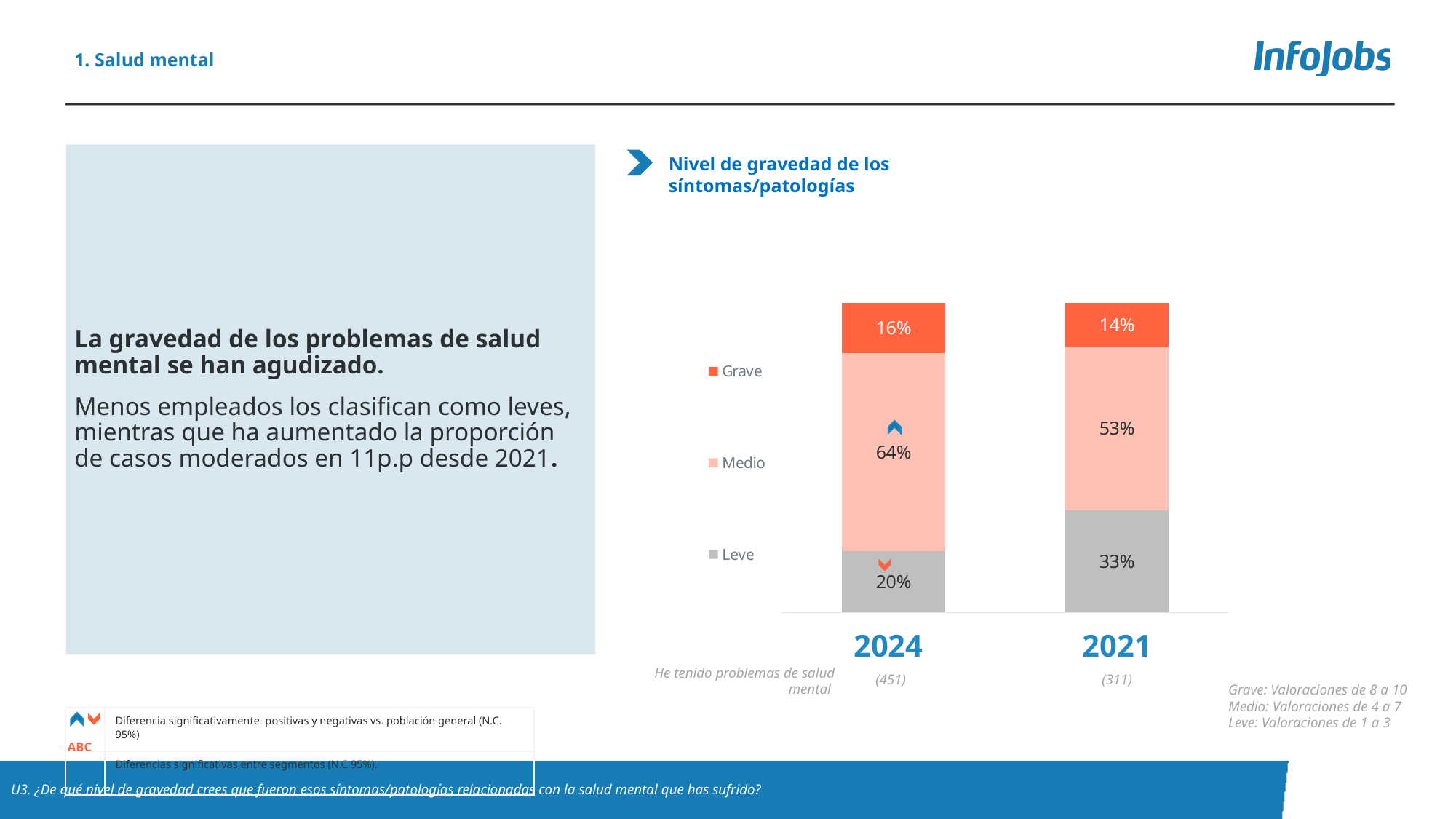
How many series does the legend list? 3 What is the total of the stacked bar for 2024? 100% What type of chart is shown on the slide? Stacked bar chart What is the sample size shown under the 2021 bar? (311) Which severity level has the smallest share in 2024? Grave By how many percentage points did the Medio share change from 2021 to 2024? 11 What percentage of respondents rated their symptoms as Grave in 2024? 16% Is the Leve share larger in 2024 or in 2021? 2021 What is the value for Grave in 2021? 14% Which severity level has the largest share in 2021? Medio What percentage of respondents rated their symptoms as Leve in 2021? 33% What is the value for Medio in 2024? 64%